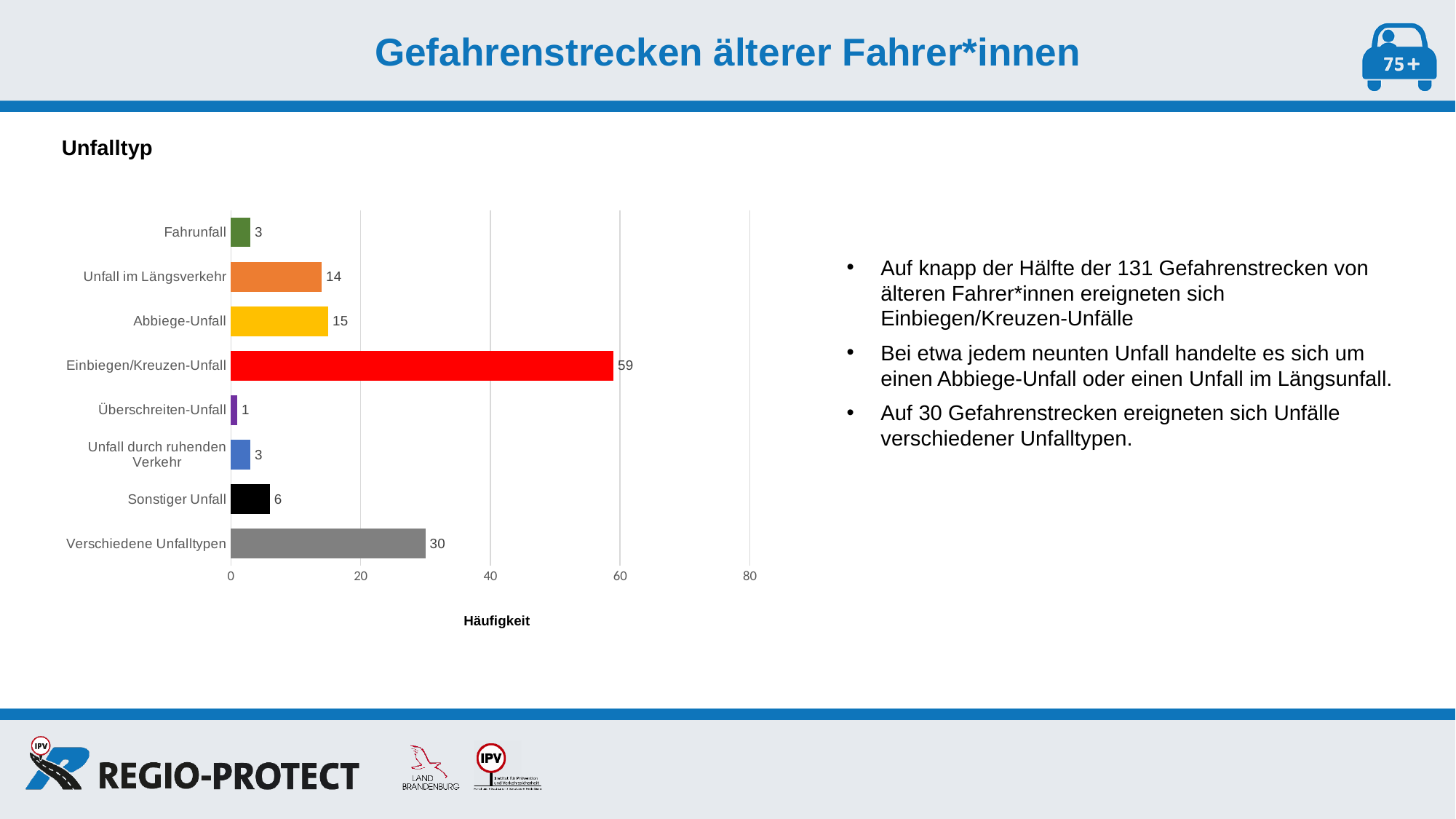
How many categories are shown in the chart? 8 What is the value for Sonstiger Unfall? 6 What is the value for Unfall im Längsverkehr? 14 What is the label of the horizontal axis of the chart? Häufigkeit Which category has the highest value? Einbiegen/Kreuzen-Unfall What is the value for Verschiedene Unfalltypen? 30 What is the value for Einbiegen/Kreuzen-Unfall? 59 What is the difference between the values for Einbiegen/Kreuzen-Unfall and Verschiedene Unfalltypen? 29 What kind of chart is shown on the slide? bar chart Which is larger, the value for Abbiege-Unfall or the value for Unfall im Längsverkehr? Abbiege-Unfall Is the value for Verschiedene Unfalltypen greater or less than 40? less Which category has the lowest value? Überschreiten-Unfall